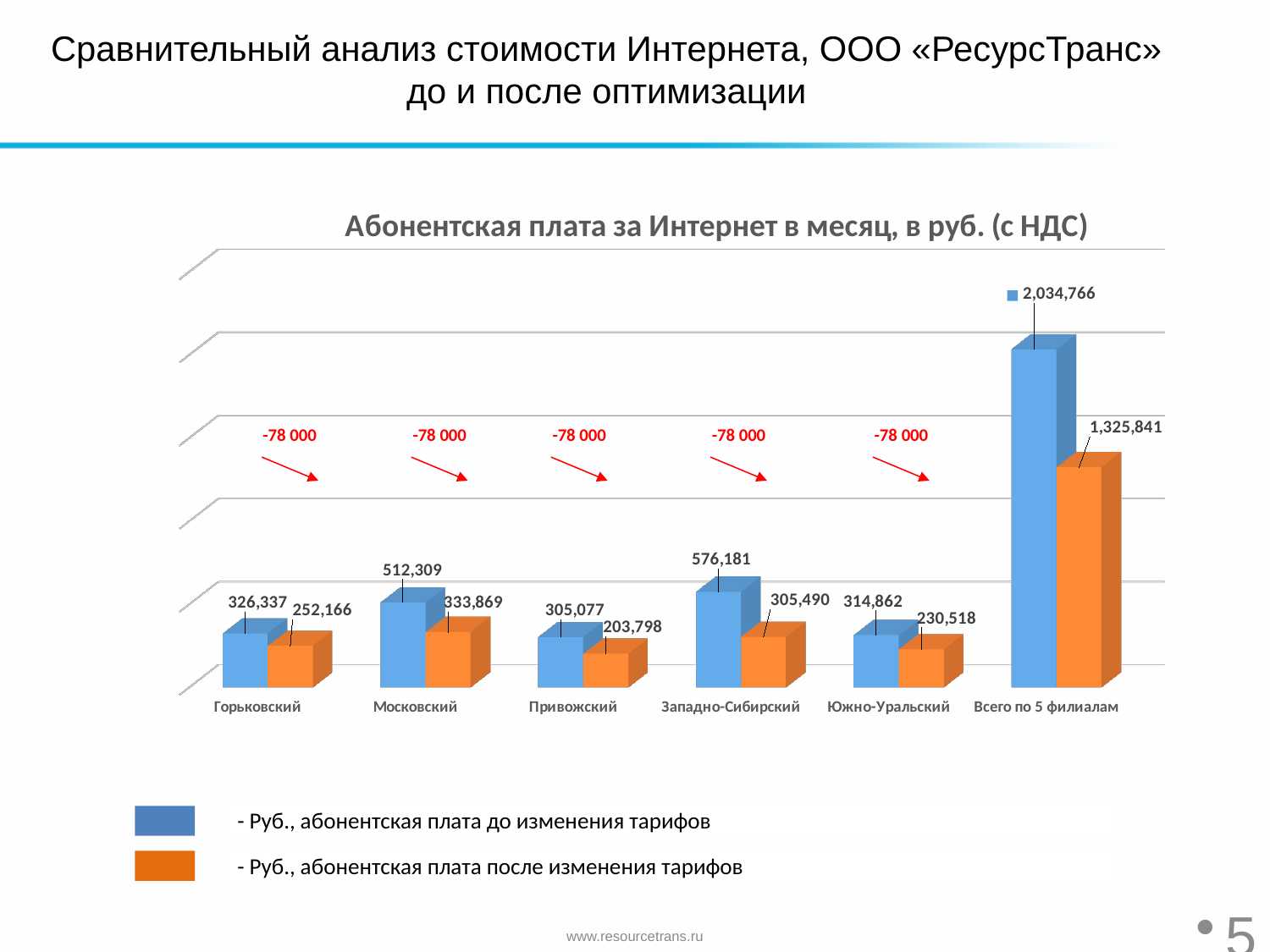
How many categories are shown on the x axis? 6 How many series does the legend list? 2 What is the value for Всего по 5 филиалам before the tariff change? 2,034,766 What kind of chart is shown on the slide? Bar chart Which is larger: the after-change value for Московский or the after-change value for Горьковский? Московский What is the difference between the before and after values for Всего по 5 филиалам? 708,925 What is the title of the chart? Абонентская плата за Интернет в месяц, в руб. (с НДС) Among the five individual branches, which has the highest value before the tariff change? Западно-Сибирский What is the value for Привожский after the tariff change? 203,798 What is the value for Московский in the blue series (before the tariff change)? 512,309 What is the value for Западно-Сибирский in the orange series (after the tariff change)? 305,490 Among the five individual branches, which has the lowest value after the tariff change? Привожский